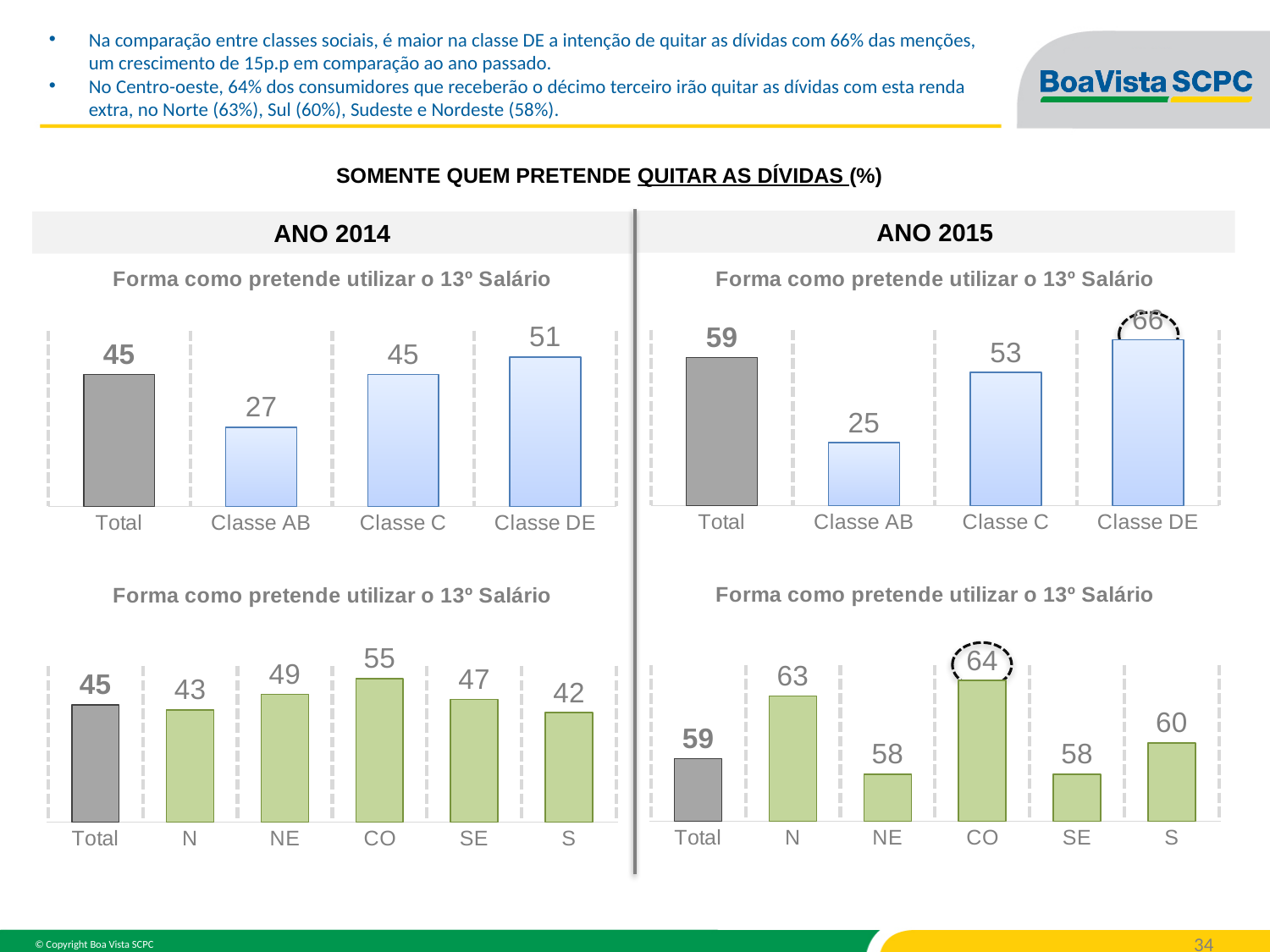
In the bottom-left chart (ANO 2014, by region), which is larger, the value for NE or the value for SE? NE In the bottom-left chart (ANO 2014, by region), which region has the lowest value? S In the bottom-right chart (ANO 2015, by region), what is the value for S? 60 In the top-left chart (ANO 2014, by class), what is the value for Classe AB? 27 In the top-right chart (ANO 2015, by class), which category has the lowest value? Classe AB In the top-right chart (ANO 2015, by class), what is the difference between Classe DE and Classe AB? 41 In the bottom-right chart (ANO 2015, by region), which region has the highest value? CO In the bottom-right chart (ANO 2015, by region), how many categories are plotted? 6 In the top-left chart (ANO 2014, by class), which category has the highest value? Classe DE In the top-right chart (ANO 2015, by class), what is the value for Classe DE? 66 What type of chart is the top-left chart (ANO 2014, by class)? Bar chart In the bottom-left chart (ANO 2014, by region), what is the value for CO? 55